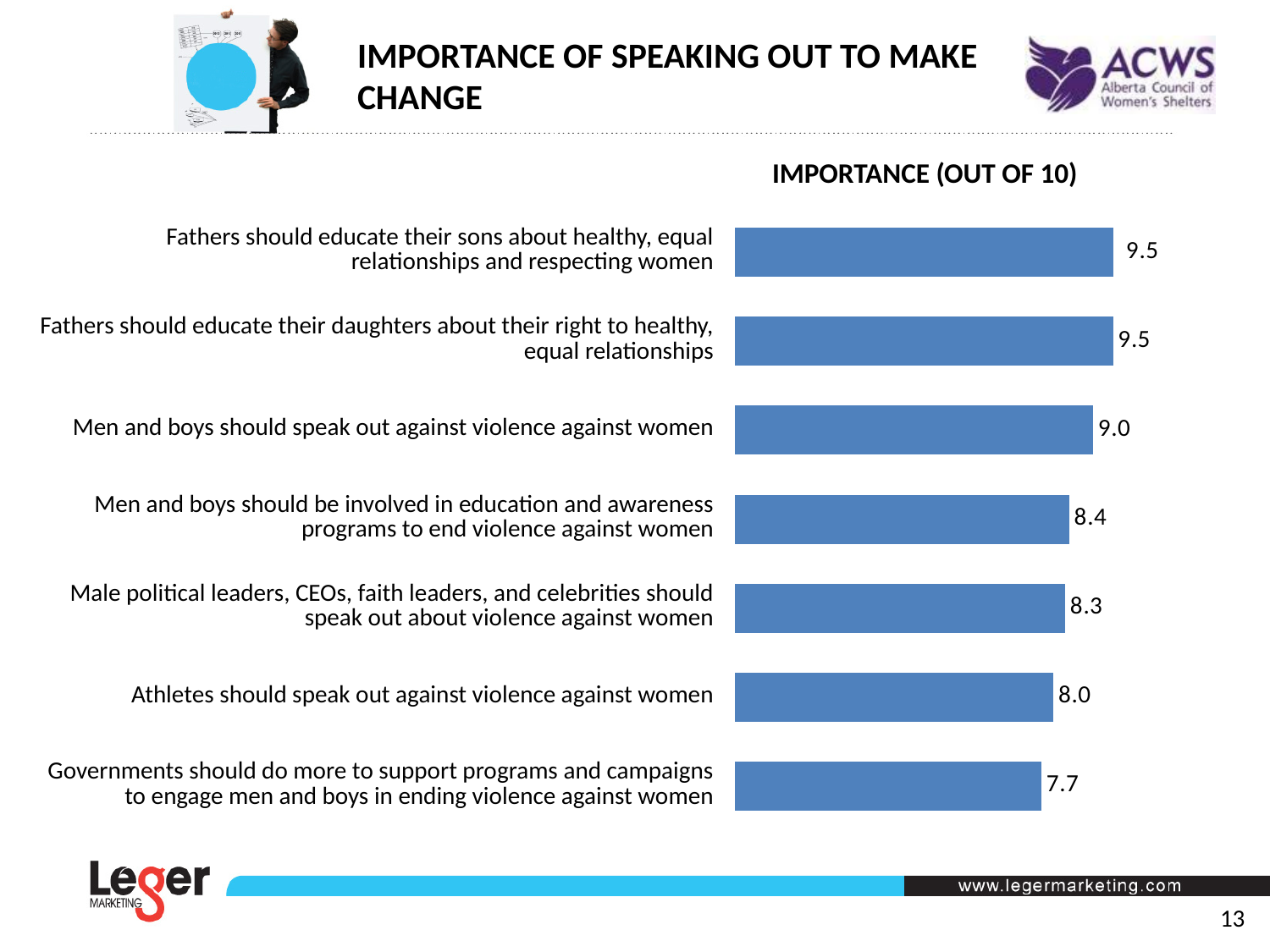
Which statement has the lowest importance score? Governments should do more to support programs and campaigns to engage men and boys in ending violence against women What is the difference between the importance score for "Men and boys should speak out against violence against women" and the score for "Athletes should speak out against violence against women"? 1.0 What is the title shown above the chart? IMPORTANCE (OUT OF 10) How many statements are shown on the chart? 7 What is the importance score for "Athletes should speak out against violence against women"? 8.0 What kind of chart is shown on the slide? Bar chart What is the importance score for "Governments should do more to support programs and campaigns to engage men and boys in ending violence against women"? 7.7 What is the highest importance score shown on the chart? 9.5 Which has a higher importance score: "Men and boys should be involved in education and awareness programs to end violence against women" or "Athletes should speak out against violence against women"? Men and boys should be involved in education and awareness programs to end violence against women What is the difference between the importance score for "Fathers should educate their sons about healthy, equal relationships and respecting women" and the score for "Governments should do more to support programs and campaigns to engage men and boys in ending violence against women"? 1.8 What is the importance score for "Men and boys should speak out against violence against women"? 9.0 What is the importance score for "Male political leaders, CEOs, faith leaders, and celebrities should speak out about violence against women"? 8.3